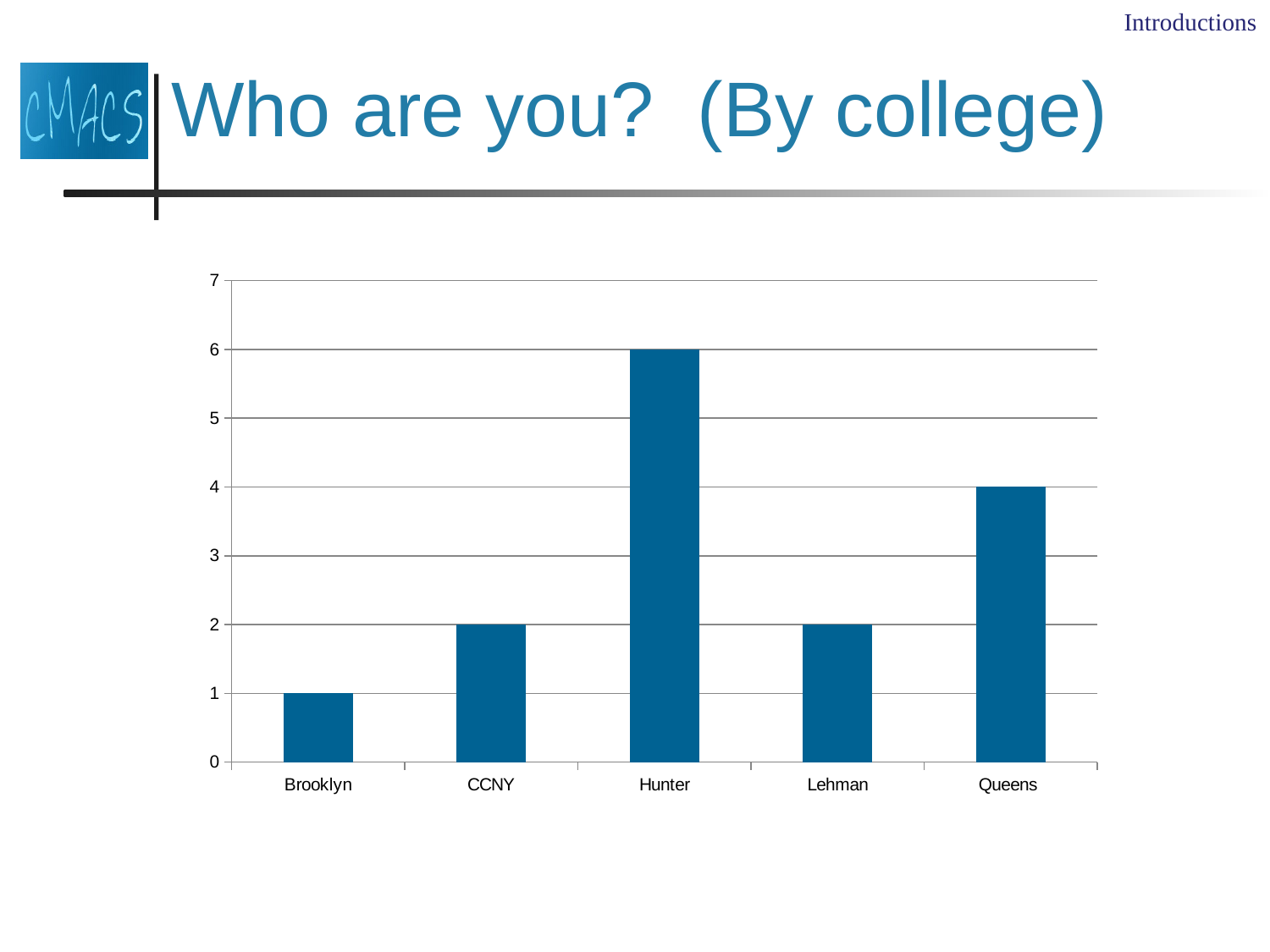
Which is larger, the value for Queens or the value for Lehman? Queens What is the value for Queens? 4 What is the value for Hunter? 6 Which college has the lowest bar? Brooklyn What is the difference between the values for CCNY and Brooklyn? 1 How many colleges are shown on the x axis? 5 Which college has the highest bar? Hunter What is the difference between the values for Hunter and Queens? 2 What is the value for Brooklyn? 1 What kind of chart is shown on the slide? bar chart What is the title of the slide containing the chart? Who are you? (By college) Is the value for Hunter greater or less than 5? greater